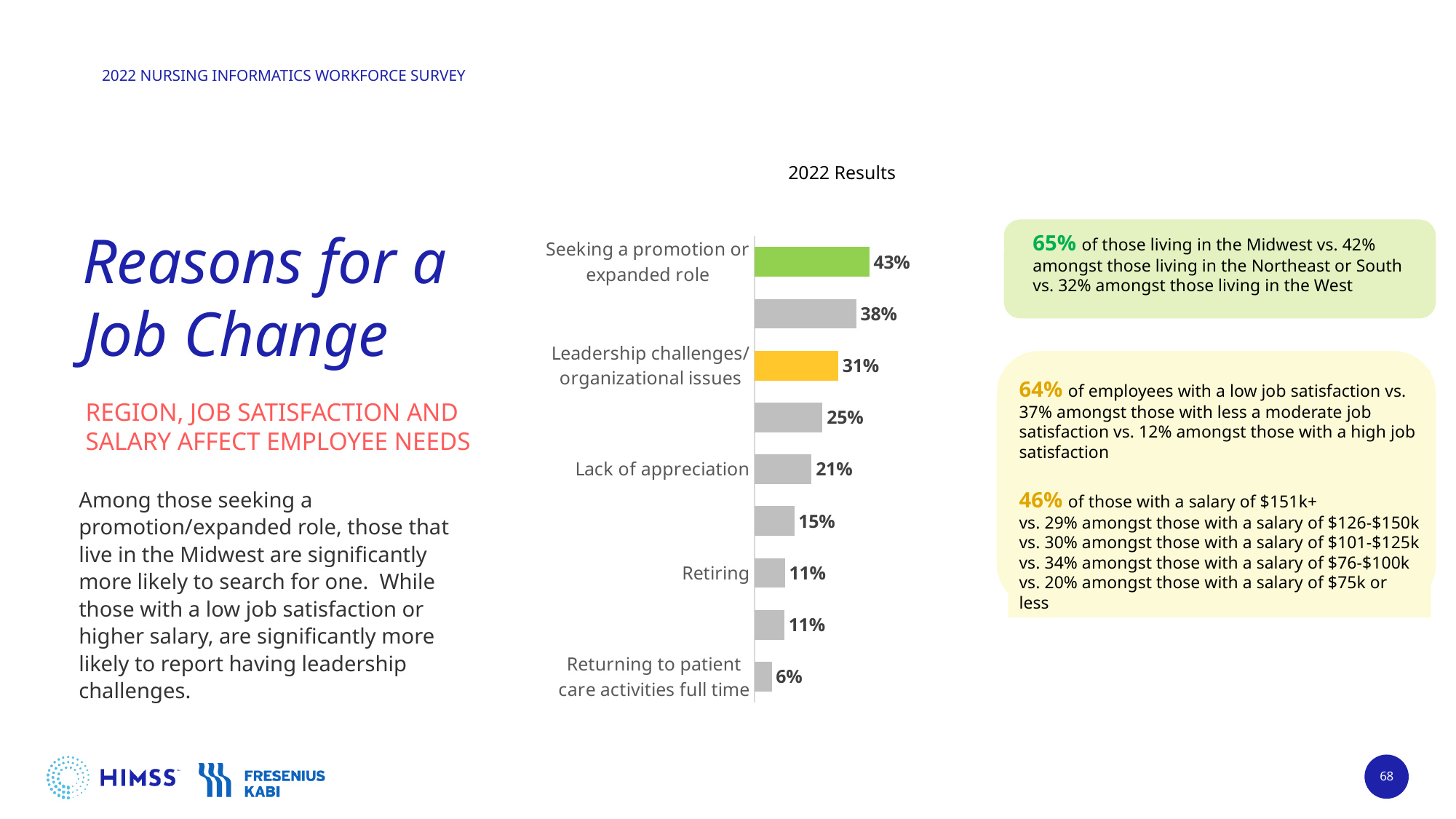
What kind of chart is shown on the slide? Bar chart Which category has the highest value? Seeking a promotion or expanded role What is the value for "Lack of appreciation"? 21% Which category has the lowest value? Returning to patient care activities full time What is the value for "Leadership challenges/ organizational issues"? 31% What is the value for "Returning to patient care activities full time"? 6% What is the value for "Seeking a promotion or expanded role"? 43% How many bars are plotted in the chart? 9 What is the difference between the values for "Seeking a promotion or expanded role" and "Leadership challenges/ organizational issues"? 12% What is the title of the chart? 2022 Results What is the value for "Retiring"? 11% Which is larger, the value for "Lack of appreciation" or the value for "Retiring"? Lack of appreciation